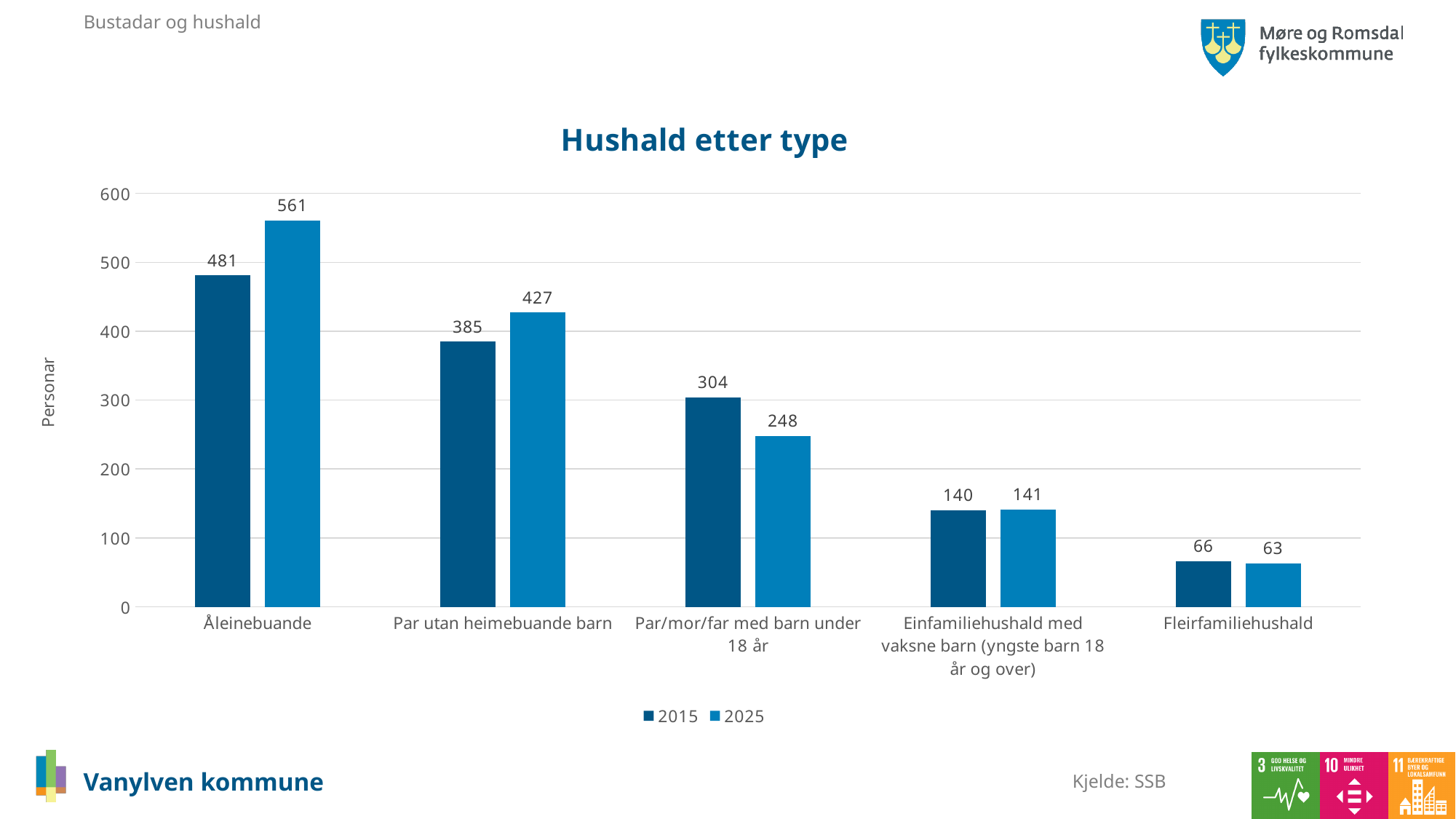
Which category has the highest value in 2015? Åleinebuande What kind of chart is shown on the slide? Bar chart Which is larger for Par utan heimebuande barn: the 2015 value or the 2025 value? 2025 What is the value for Fleirfamiliehushald in 2025? 63 Which category has the lowest value in 2025? Fleirfamiliehushald What is the difference between the 2015 and 2025 values for Par/mor/far med barn under 18 år? 56 What is the value for Par utan heimebuande barn in 2015? 385 What is the value for Åleinebuande in 2025? 561 How many household categories are shown on the x axis? 5 What is the title of the chart? Hushald etter type How many series does the legend list? 2 What is the difference between the 2025 and 2015 values for Åleinebuande? 80